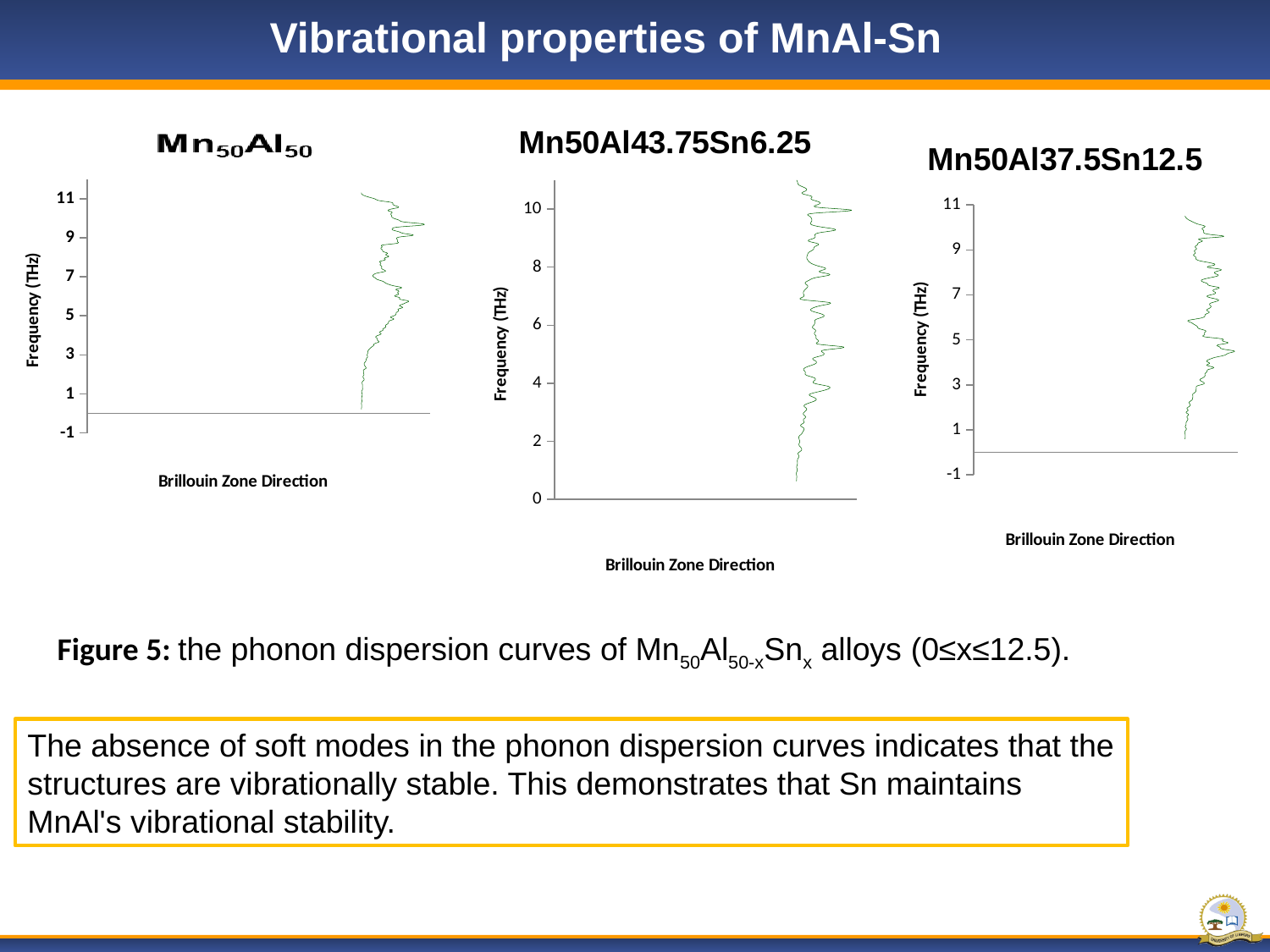
In the Mn50Al50 chart on the left, is the lowest frequency reached by the curve greater or less than 3? less In the Mn50Al43.75Sn6.25 chart in the middle, is the highest frequency reached by the curve greater or less than 8? greater What is the x-axis title of the Mn50Al37.5Sn12.5 chart on the right of the slide? Brillouin Zone Direction How many charts are shown on the slide? 3 In the Mn50Al43.75Sn6.25 chart in the middle, is the lowest frequency reached by the curve greater or less than 2? less What is the y-axis title of the Mn50Al43.75Sn6.25 chart in the middle of the slide? Frequency (THz) What kind of chart is the Mn50Al50 chart on the left of the slide? line chart